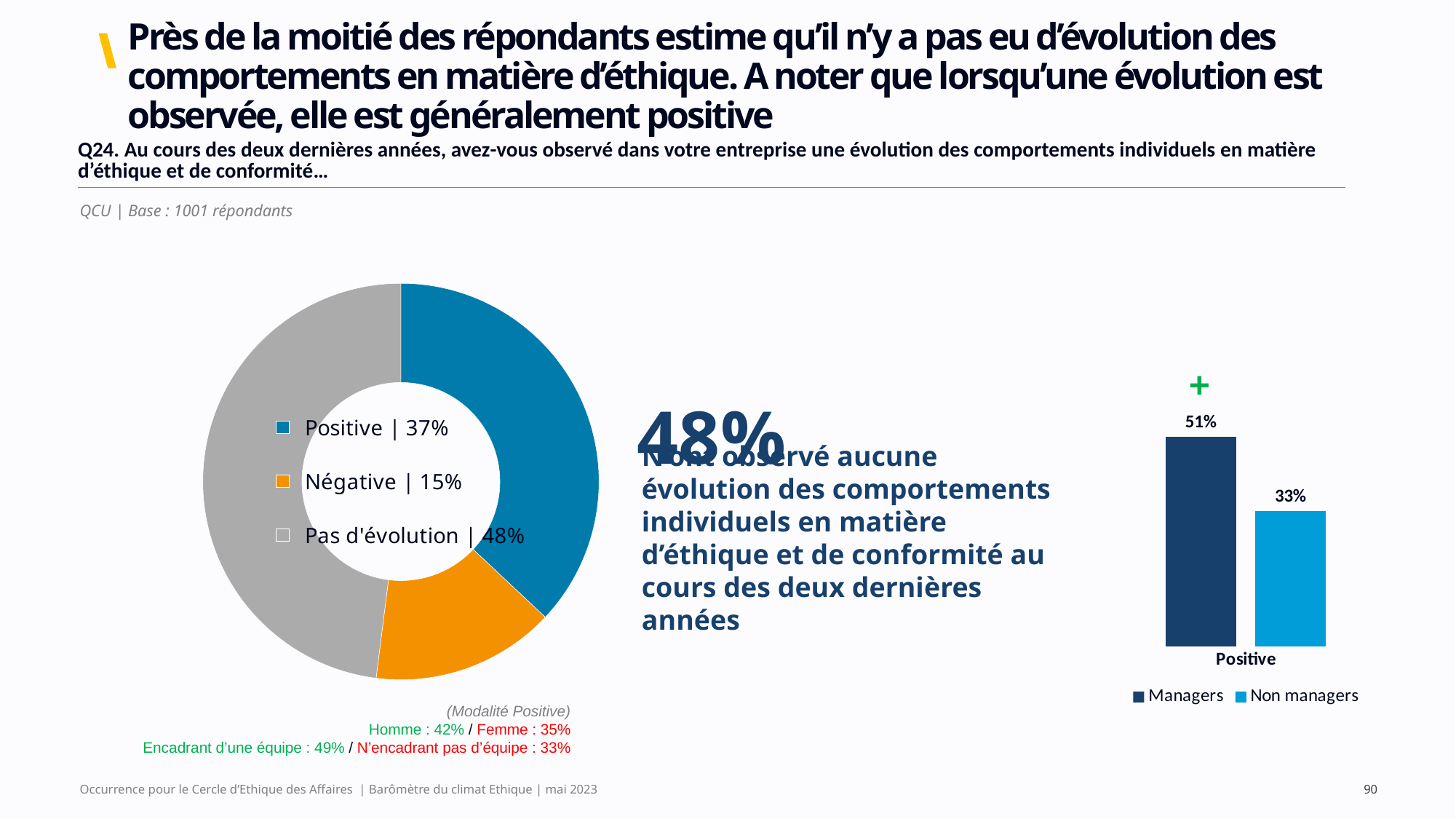
In the bar chart on the right, how many series does the legend list? 2 In the donut chart on the left, which category has the smallest share? Négative In the donut chart on the left, what is the value for Négative? 15% In the donut chart on the left, how many categories are shown? 3 What kind of chart is shown on the left of the slide? Donut (pie) chart In the donut chart on the left, what is the value for Pas d'évolution? 48% In the bar chart on the right, what is the value for Non managers? 33% In the bar chart on the right, what is the value for Managers? 51% In the donut chart on the left, which category has the largest share? Pas d'évolution In the donut chart on the left, what is the difference between Pas d'évolution and Positive? 11 percentage points In the bar chart on the right, what is the difference between Managers and Non managers? 18 percentage points In the donut chart on the left, what is the value for Positive? 37%